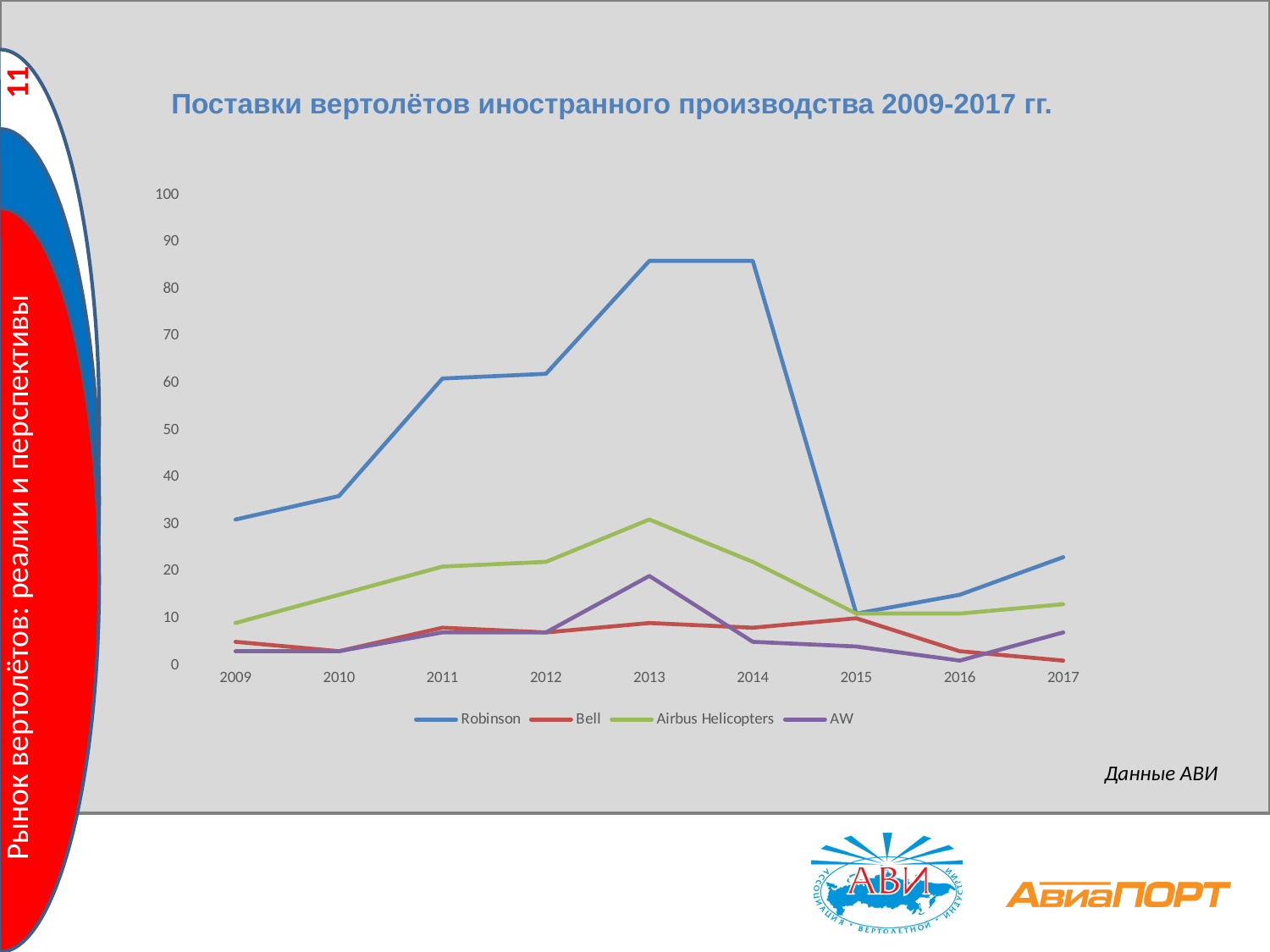
Is the value for Robinson in 2013 greater or less than 80? greater Is the value for Airbus Helicopters in 2013 greater or less than 20? greater What is the title of the chart? Поставки вертолётов иностранного производства 2009-2017 гг. Is the value for Bell in 2017 greater or less than 10? less Which series is shown with the blue line? Robinson How many years are plotted along the x axis? 9 How many series does the legend list? 4 Which is larger in 2012, the value for Robinson or the value for Airbus Helicopters? Robinson What kind of chart is shown on the slide? line chart Which series has the lowest value in 2017? Bell Which series has the highest value in 2013? Robinson